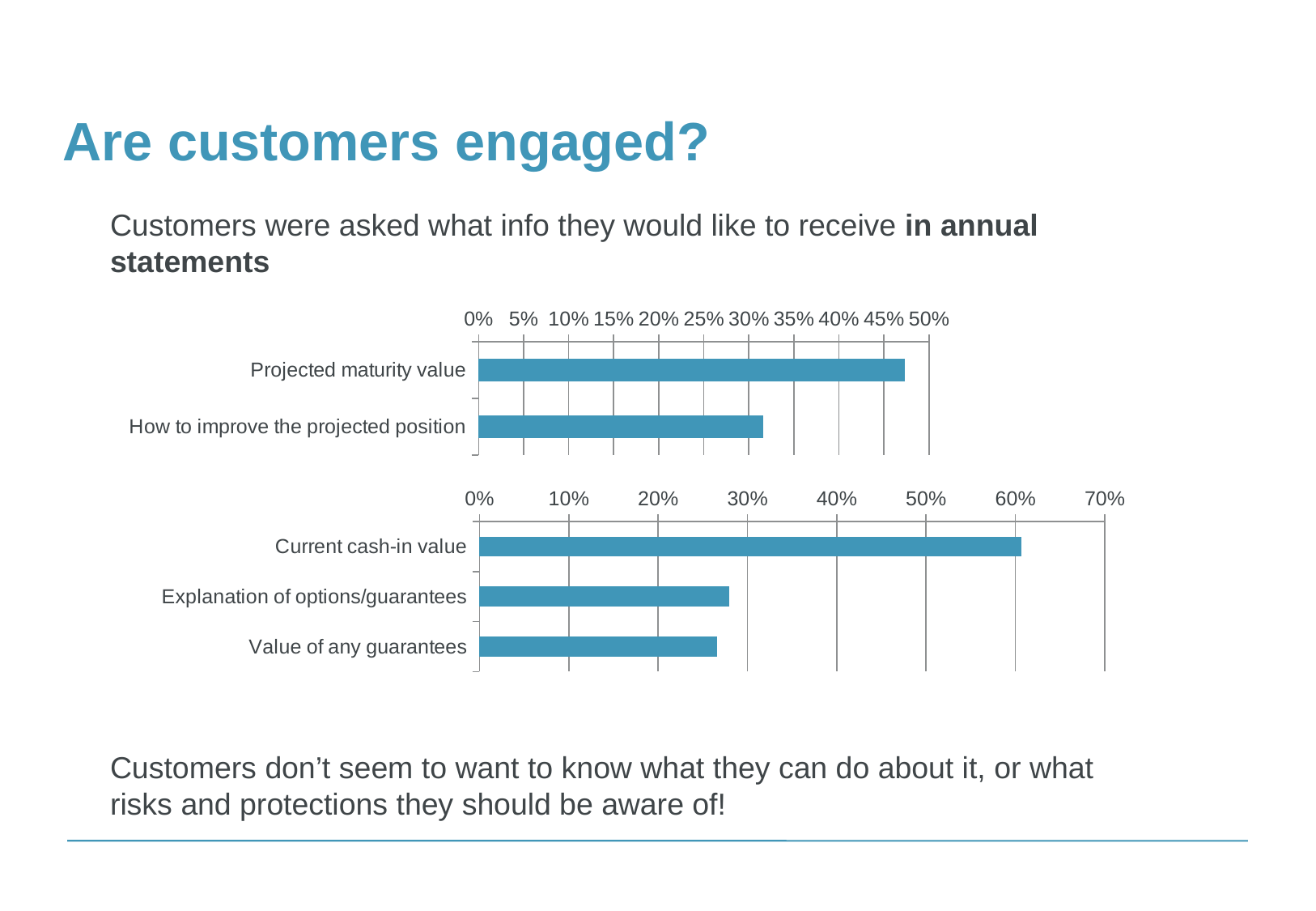
In the top chart, is the value for Projected maturity value greater or less than 45%? greater In the top chart, how many categories are plotted? 2 In the top chart, which category has the lowest value? How to improve the projected position What type of chart is the bottom chart? Bar chart In the bottom chart, is the value for Explanation of options/guarantees greater or less than 30%? less In the bottom chart, how many categories are plotted? 3 In the top chart, is the value for How to improve the projected position greater or less than 35%? less In the bottom chart, which category has the highest value? Current cash-in value In the top chart, which category has the highest value? Projected maturity value In the bottom chart, which is larger: Current cash-in value or Explanation of options/guarantees? Current cash-in value